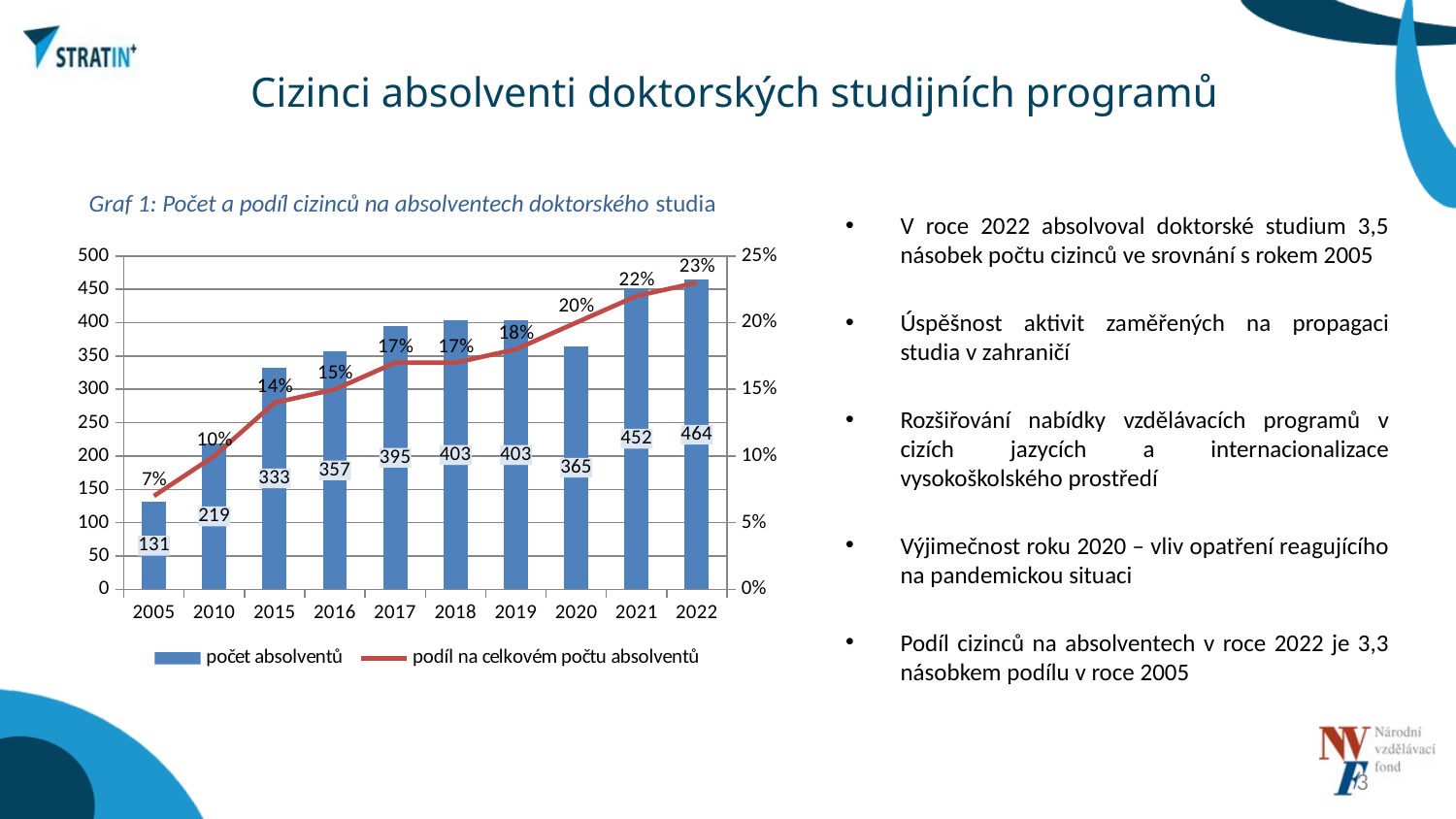
Is the 'počet absolventů' value for 2016 greater or less than 300? greater What is the difference in 'počet absolventů' between 2022 and 2005? 333 How many series does the legend list? 2 What is the value of 'počet absolventů' for 2015? 333 How many years are shown on the x axis? 10 What is the title of the chart? Graf 1: Počet a podíl cizinců na absolventech doktorského studia Which year has the lowest 'podíl na celkovém počtu absolventů'? 2005 Which year has the highest 'počet absolventů'? 2022 What kind of chart is used for 'počet absolventů'? bar chart Which year has a larger 'počet absolventů', 2017 or 2020? 2017 Does the 'podíl na celkovém počtu absolventů' line generally rise or fall from 2005 to 2022? rise What is the 'podíl na celkovém počtu absolventů' value for 2019? 18%